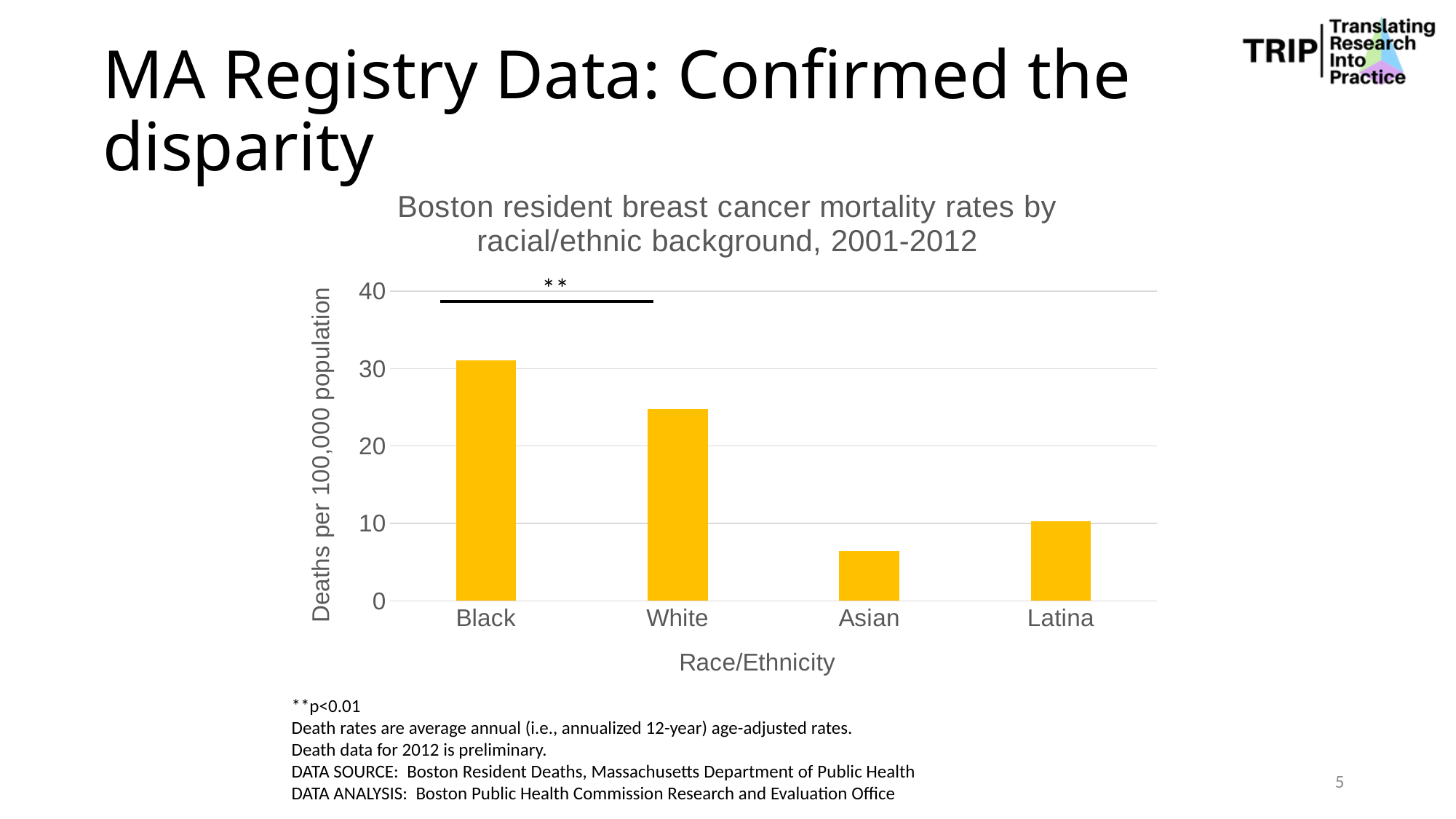
Is the value for Asian greater or less than 10? less Which group has a higher mortality rate, Latina or Asian? Latina How many racial/ethnic categories are plotted on the chart? 4 Which racial/ethnic group has the highest breast cancer mortality rate on the chart? Black Which racial/ethnic group has the lowest breast cancer mortality rate on the chart? Asian Is the value for Latina greater or less than 20? less What is the label on the vertical axis of the chart? Deaths per 100,000 population What is the title of the chart? Boston resident breast cancer mortality rates by racial/ethnic background, 2001-2012 Is the value for White greater or less than 30? less Which group has a higher mortality rate, Black or White? Black What kind of chart is shown on the slide? bar chart